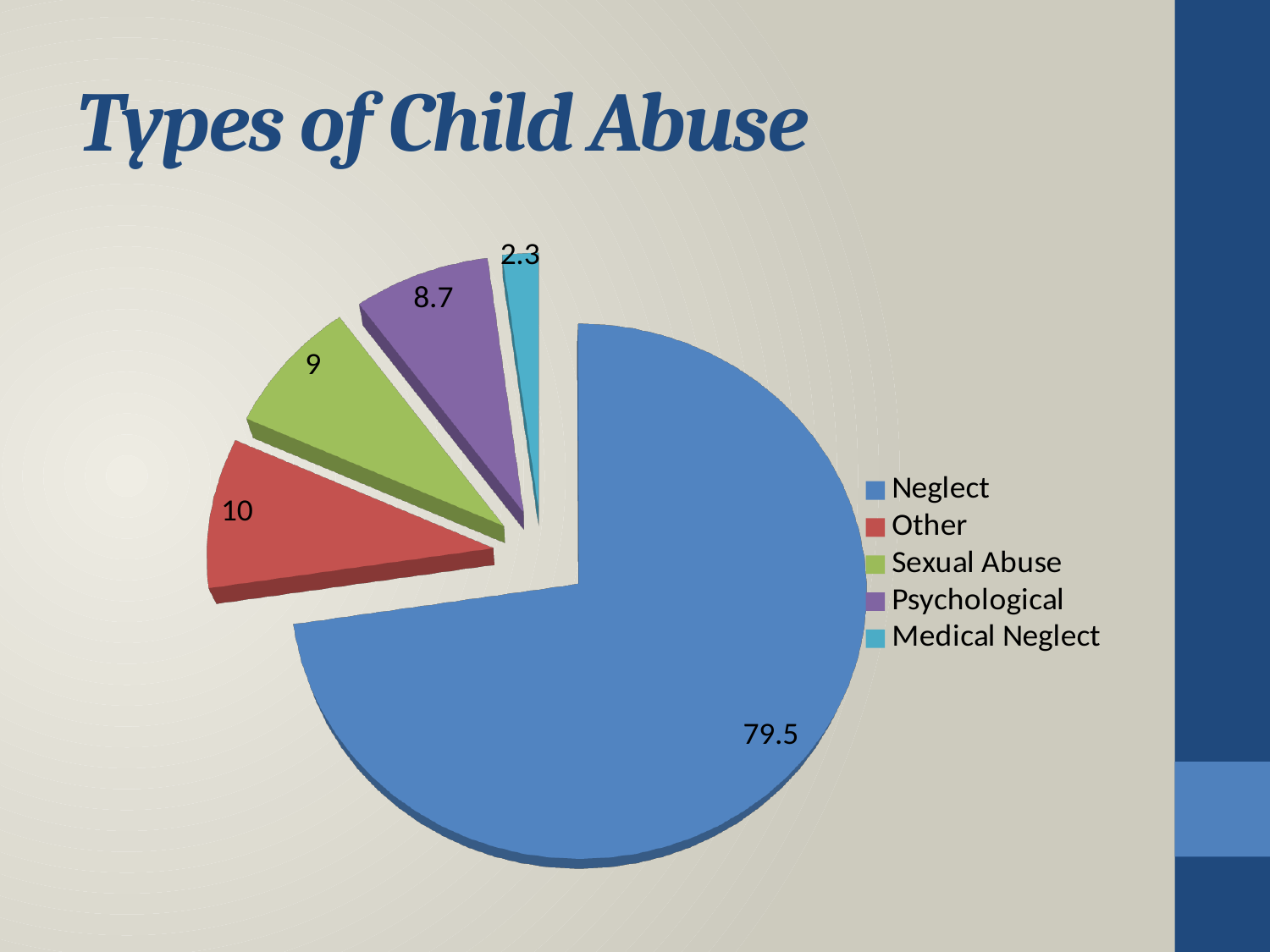
How many categories does the pie chart show? 5 Which is larger, the value for Other or the value for Medical Neglect? Other What is the value for Medical Neglect? 2.3 Which category has the largest slice? Neglect What is the value for Other? 10 What is the value for Sexual Abuse? 9 What is the value for Neglect? 79.5 What is the difference between the values for Psychological and Medical Neglect? 6.4 What is the value for Psychological? 8.7 What kind of chart is shown on the slide? Pie chart Which category has the smallest slice? Medical Neglect What is the difference between the values for Neglect and Other? 69.5